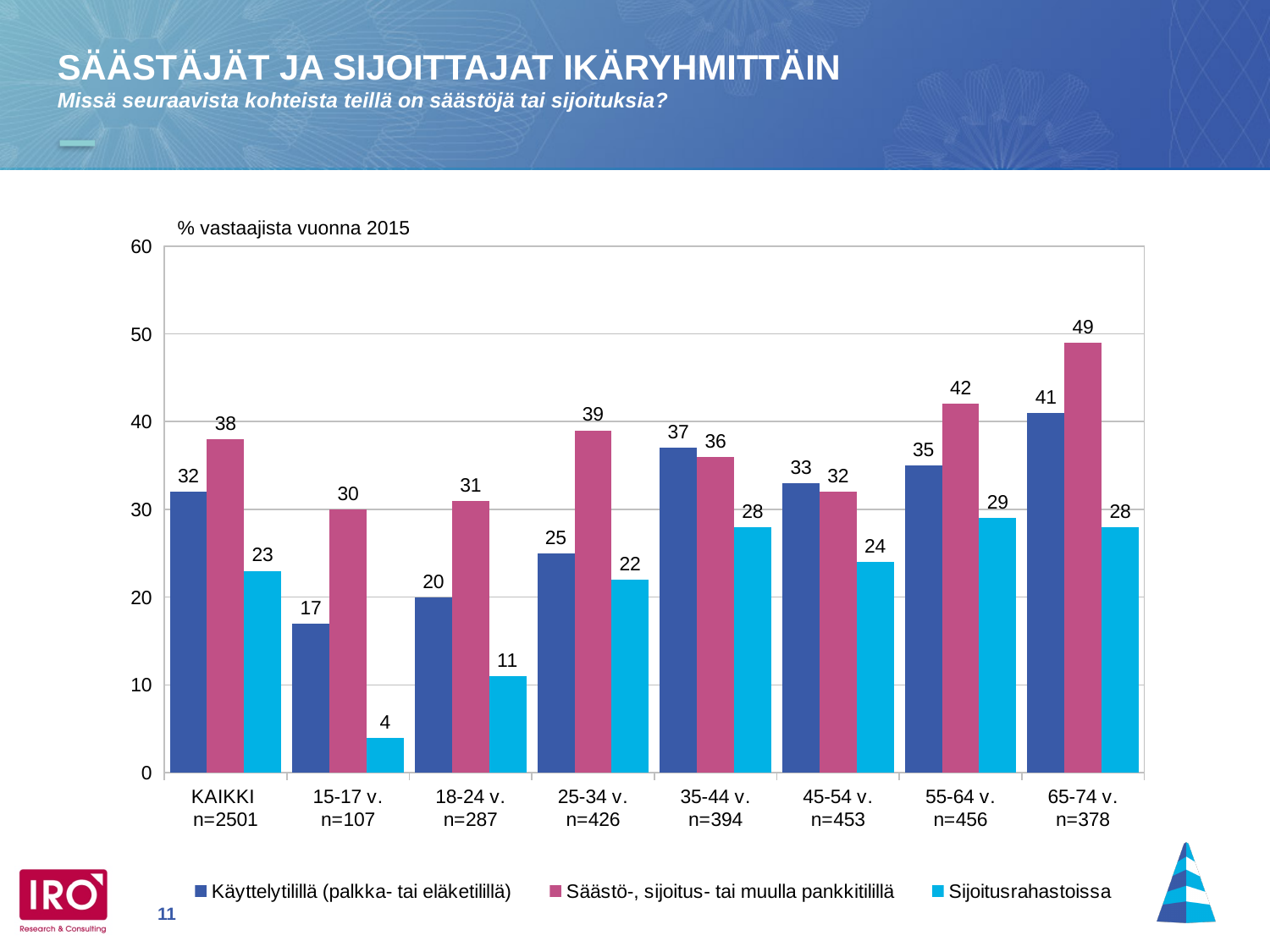
What is the value for Sijoitusrahastoissa in the 15-17 v. age group? 4 What is the sample size (n) shown for the 45-54 v. age group? n=453 How many series does the legend list? 3 How many age groups (categories) are shown on the x axis? 8 Which age group has the lowest value for Käyttelytilillä (palkka- tai eläketilillä)? 15-17 v. What kind of chart is shown on the slide? bar chart What is the value for Säästö-, sijoitus- tai muulla pankkitilillä in the 25-34 v. age group? 39 What is the value for Käyttelytilillä (palkka- tai eläketilillä) in the KAIKKI group? 32 Does the Käyttelytilillä (palkka- tai eläketilillä) value rise or fall from the 15-17 v. group to the 65-74 v. group? rise What is the difference between the Säästö-, sijoitus- tai muulla pankkitilillä value and the Sijoitusrahastoissa value in the 65-74 v. age group? 21 In the 35-44 v. age group, which is larger: Käyttelytilillä (palkka- tai eläketilillä) or Sijoitusrahastoissa? Käyttelytilillä (palkka- tai eläketilillä) Which age group has the highest value for Säästö-, sijoitus- tai muulla pankkitilillä? 65-74 v.